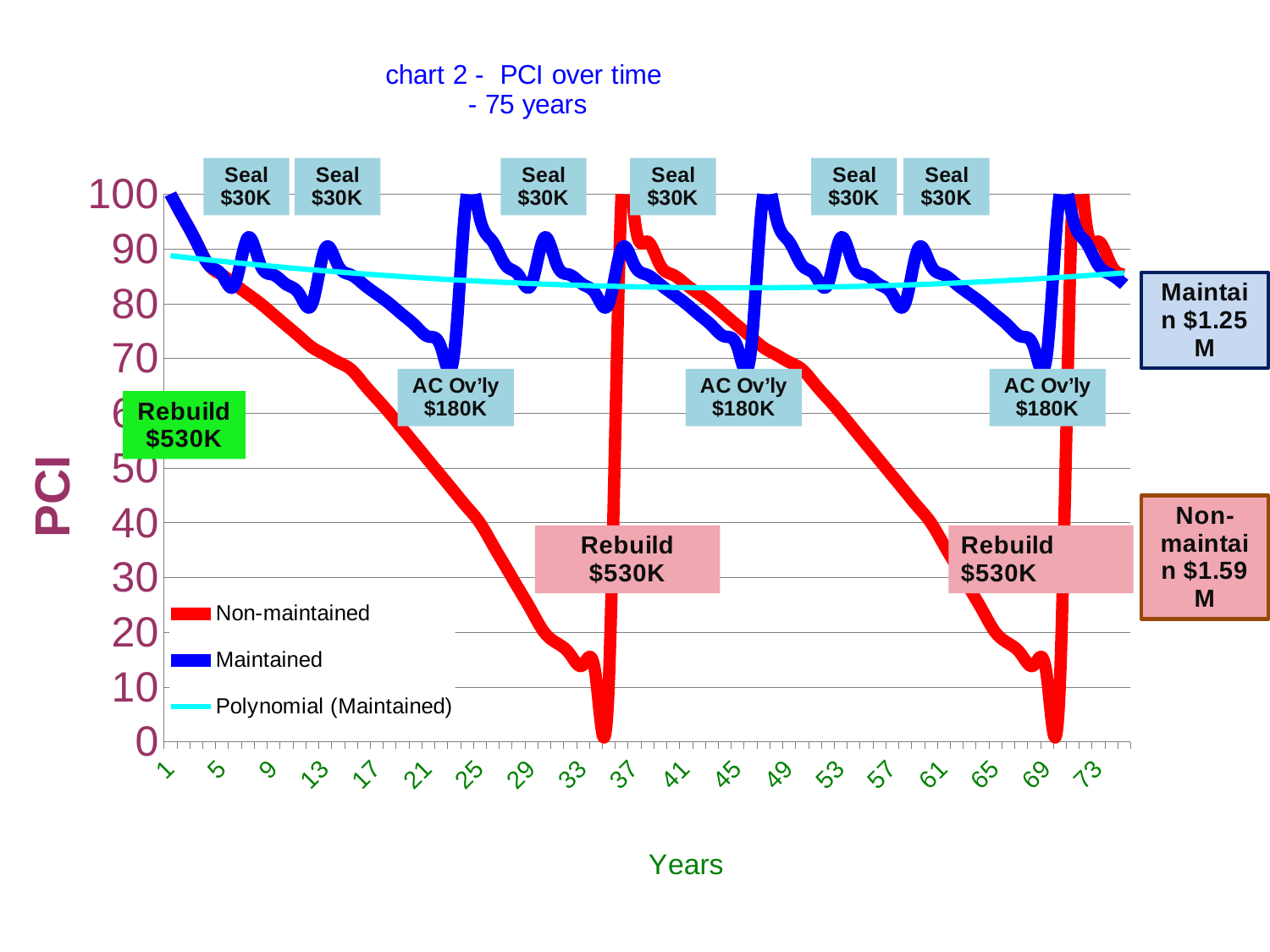
What kind of chart is shown on the slide? line chart What colour is the Maintained line? blue Is the Maintained value at year 23 greater or less than 80? less What cost is shown for each AC Ov'ly treatment? $180K How many Rebuild $530K annotations appear on the chart? 3 How many series does the legend list? 3 Is the Non-maintained value at year 49 greater or less than 80? less What cost is shown for each Seal treatment? $30K What is the title of the chart? chart 2 - PCI over time - 75 years Which total is larger, Maintain or Non-maintain? Non-maintain Is the Non-maintained value at year 17 greater or less than 60? greater